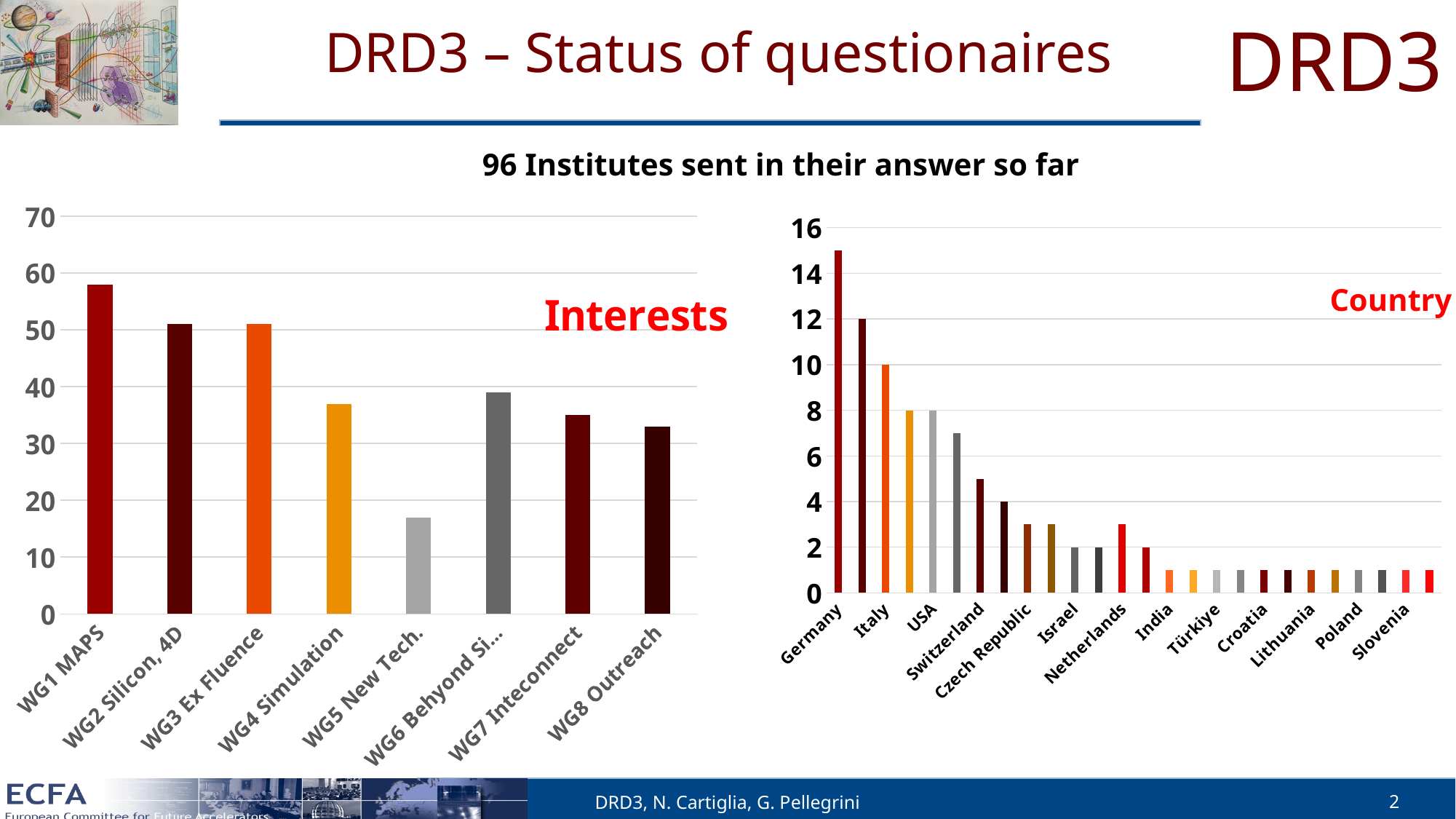
What kind of chart is the 'Interests' chart on the left of the slide? bar chart In the 'Interests' chart, which category has the highest bar? WG1 MAPS In the 'Interests' chart, is the value for WG5 New Tech. greater or less than 20? less What kind of chart is the 'Country' chart on the right of the slide? bar chart How many working-group categories are shown in the 'Interests' chart? 8 In the 'Country' chart, is the value for Germany greater or less than 14? greater In the 'Interests' chart, which category has the lowest bar? WG5 New Tech. In the 'Country' chart on the right, which country has the highest bar? Germany In the 'Country' chart, is the value for Slovenia greater or less than 2? less In the 'Interests' chart, which is larger: WG1 MAPS or WG8 Outreach? WG1 MAPS